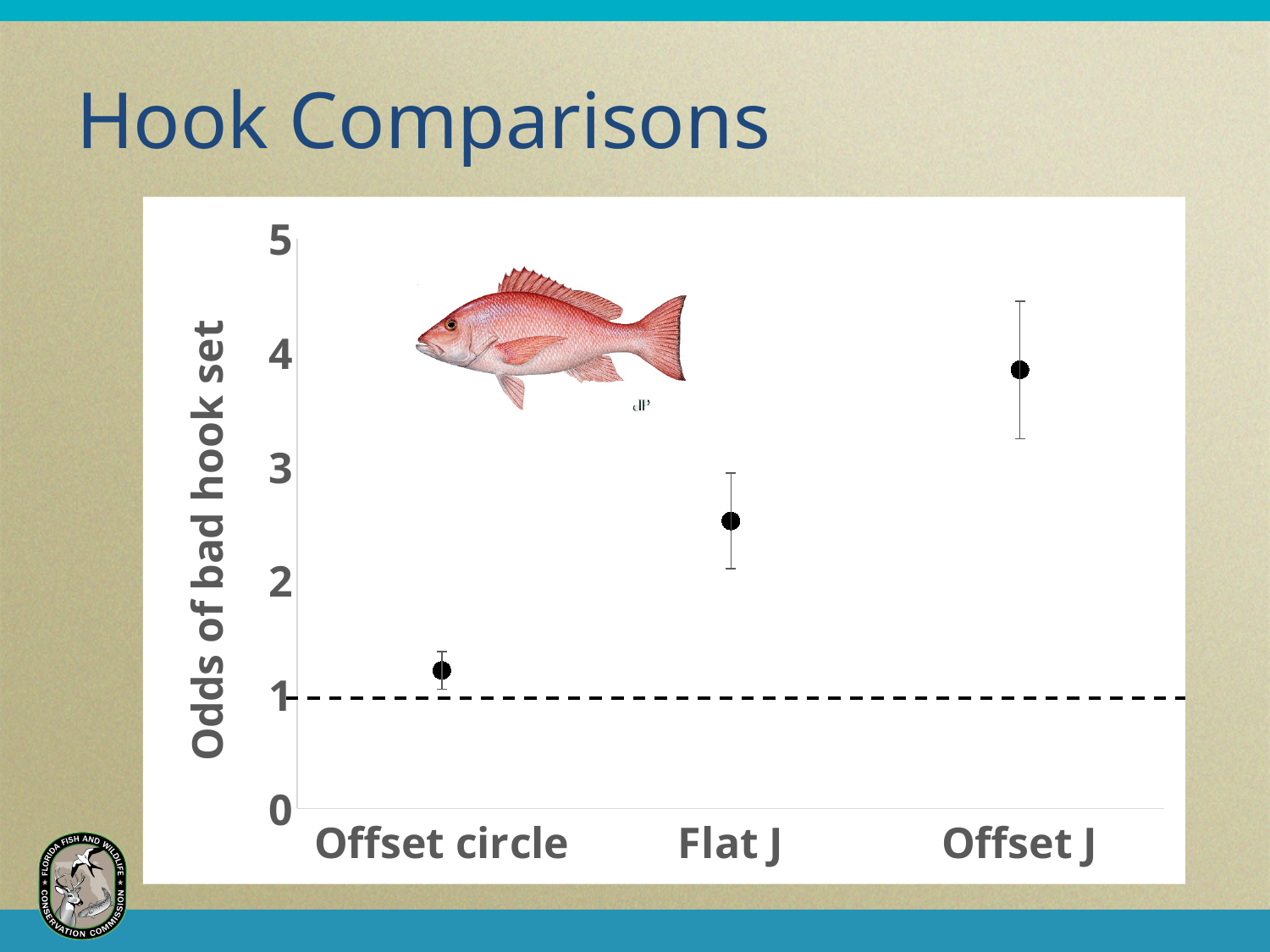
Is the value for Offset circle greater or less than 2? less Which hook type has the highest odds of bad hook set? Offset J Which hook type has the lowest odds of bad hook set? Offset circle Is the value for Flat J greater or less than 3? less What kind of chart is shown on the slide? Scatter chart with error bars Which has higher odds of bad hook set, Flat J or Offset J? Offset J Do the plotted values rise or fall from Offset circle to Offset J along the x axis? Rise Which has lower odds of bad hook set, Offset circle or Flat J? Offset circle How many hook types are plotted on the chart? 3 Is the value for Offset J greater or less than 3? greater What is the label on the y axis of the chart? Odds of bad hook set